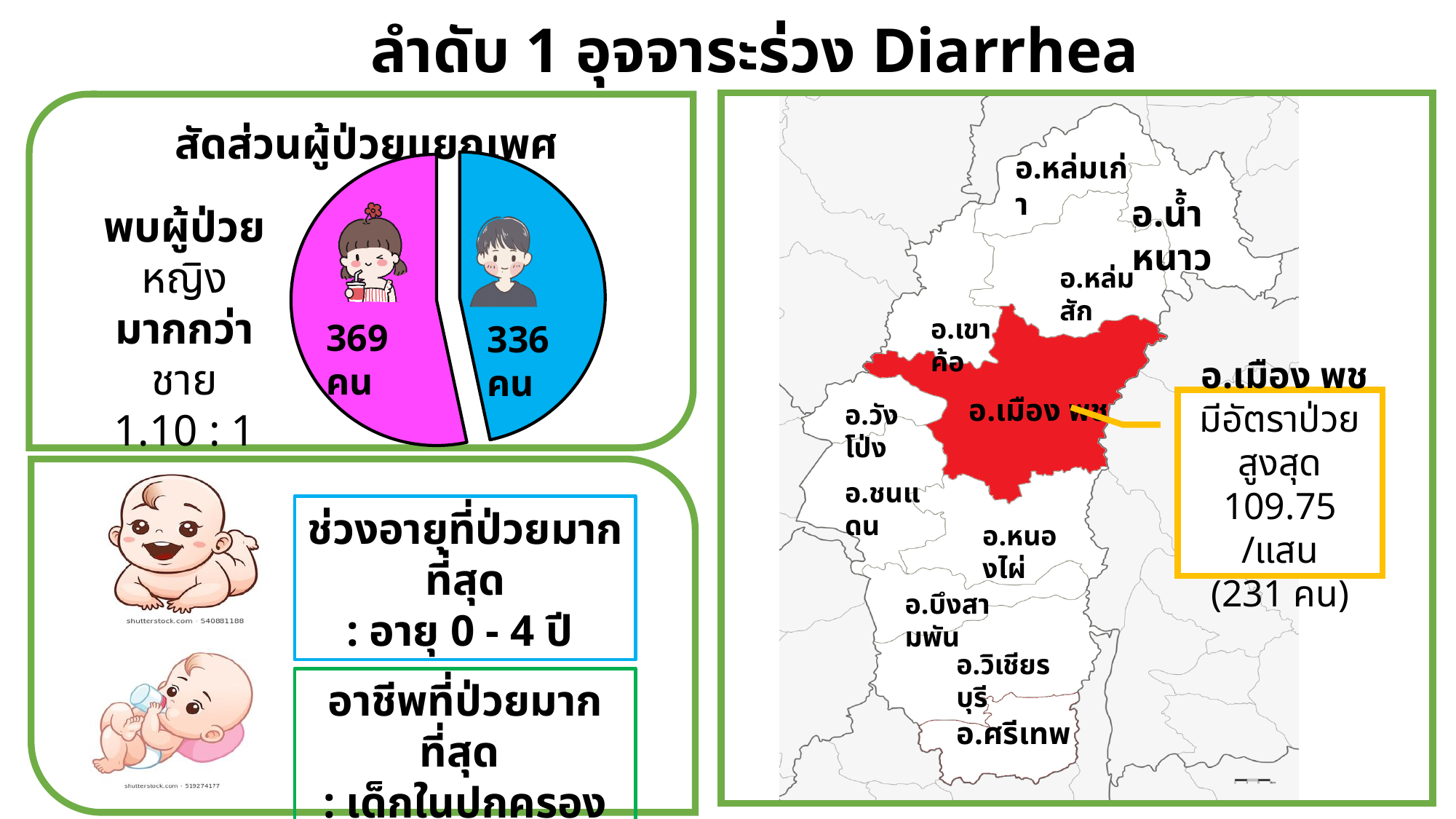
What colour is the slice representing female patients in the pie chart? pink Is the number of female patients in the pie chart greater or less than the number of male patients? greater Which group has the larger slice in the pie chart, female (หญิง) or male (ชาย)? หญิง (female) What is the total number of patients represented by the two slices of the pie chart? 705 คน What female-to-male ratio is stated next to the pie chart? 1.10 : 1 How many slices does the pie chart have? 2 In the pie chart, how many female (หญิง) patients are shown? 369 คน What kind of chart is shown on the left side of the slide under the heading สัดส่วนผู้ป่วยแยกเพศ? pie chart What colour is the slice representing male patients in the pie chart? blue What is the difference between the number of female and male patients in the pie chart? 33 คน In the pie chart, how many male (ชาย) patients are shown? 336 คน Which group has the smaller slice in the pie chart? ชาย (male)